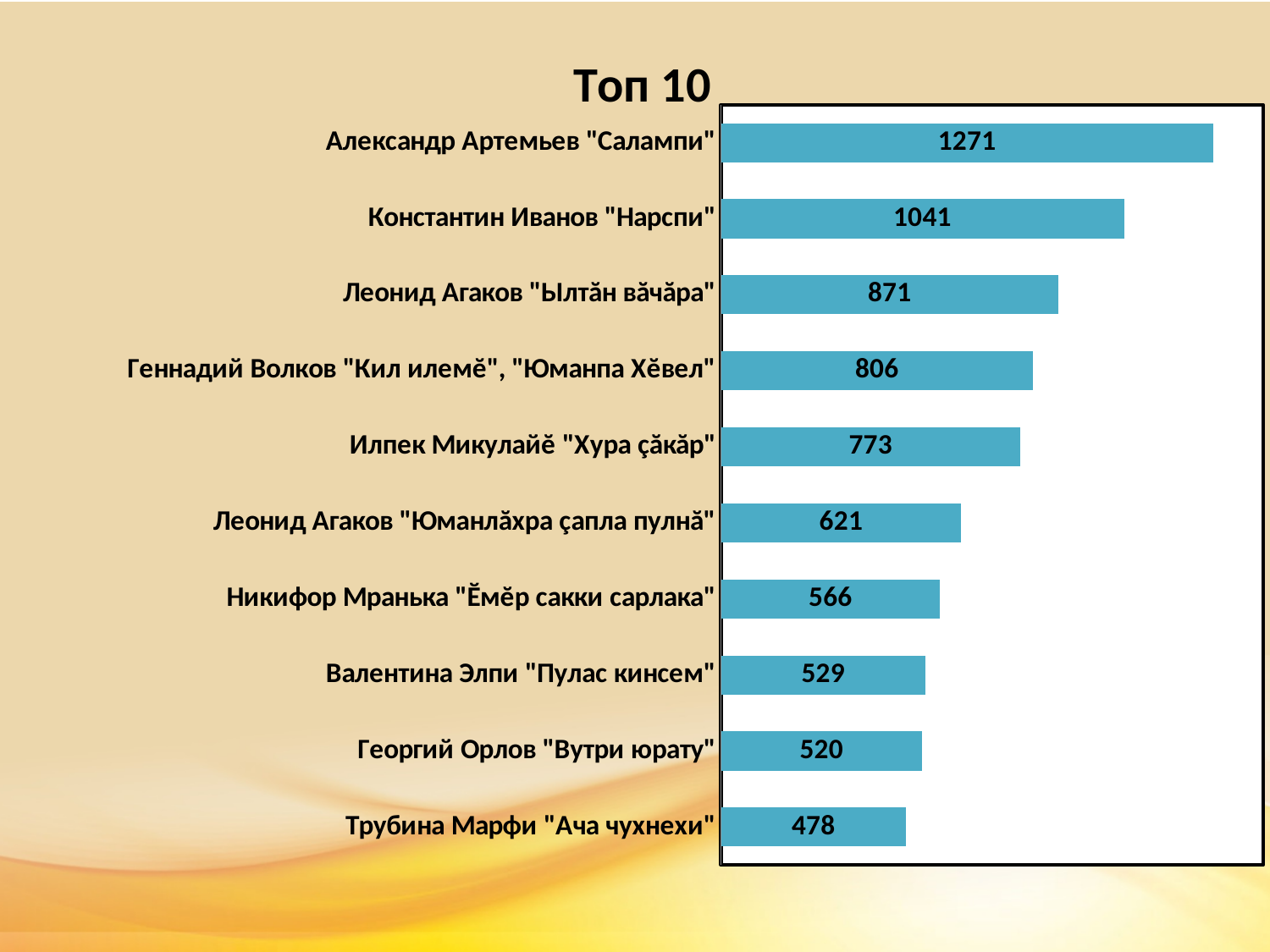
How many categories are shown in the chart? 10 What is the value for Александр Артемьев "Салампи"? 1271 Which category has the lowest value? Трубина Марфи "Ача чухнехи" What is the value for Илпек Микулайĕ "Хура çăкăр"? 773 What is the title of the chart? Топ 10 What kind of chart is shown on the slide? Bar chart What is the value for Георгий Орлов "Вутри юрату"? 520 Which category has the highest value? Александр Артемьев "Салампи" What is the difference between the values for Александр Артемьев "Салампи" and Константин Иванов "Нарспи"? 230 What is the difference between the values for Леонид Агаков "Ылтăн вăчăра" and Геннадий Волков "Кил илемĕ", "Юманпа Хĕвел"? 65 Which is larger, the value for Никифор Мранька "Ĕмĕр сакки сарлака" or the value for Валентина Элпи "Пулас кинсем"? Никифор Мранька "Ĕмĕр сакки сарлака" What is the value for Трубина Марфи "Ача чухнехи"? 478